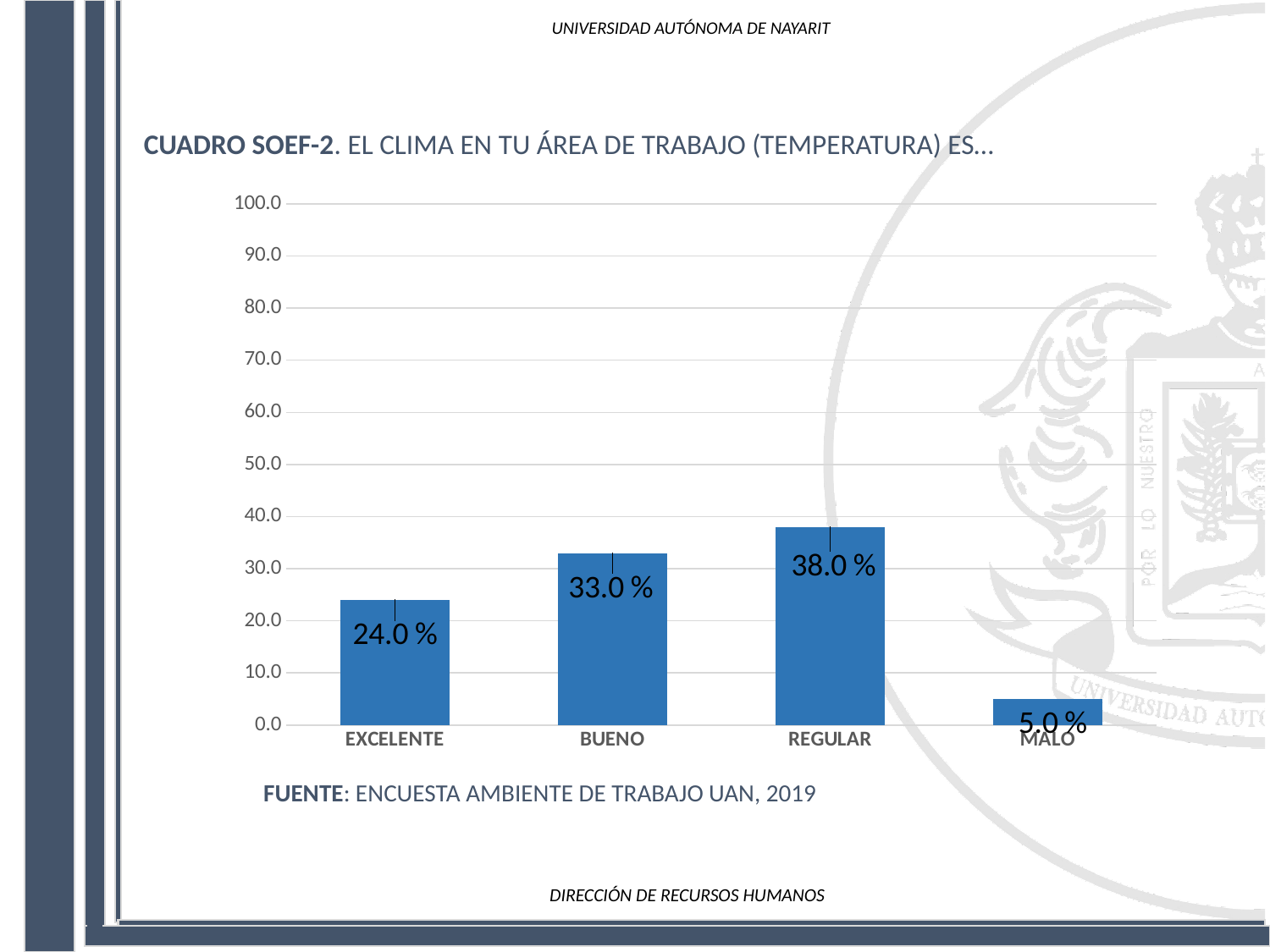
Which is larger, the value for BUENO or the value for EXCELENTE? BUENO Which category has the highest value? REGULAR What is the difference between the values for EXCELENTE and MALO? 19.0 % What is the value for BUENO? 33.0 % What is the value for MALO? 5.0 % What is the value for REGULAR? 38.0 % Which category has the lowest value? MALO What is the value for EXCELENTE? 24.0 % How many categories are shown on the x axis? 4 What kind of chart is shown on the slide? bar chart Is the value for REGULAR greater or less than 30.0? greater What is the difference between the values for REGULAR and BUENO? 5.0 %